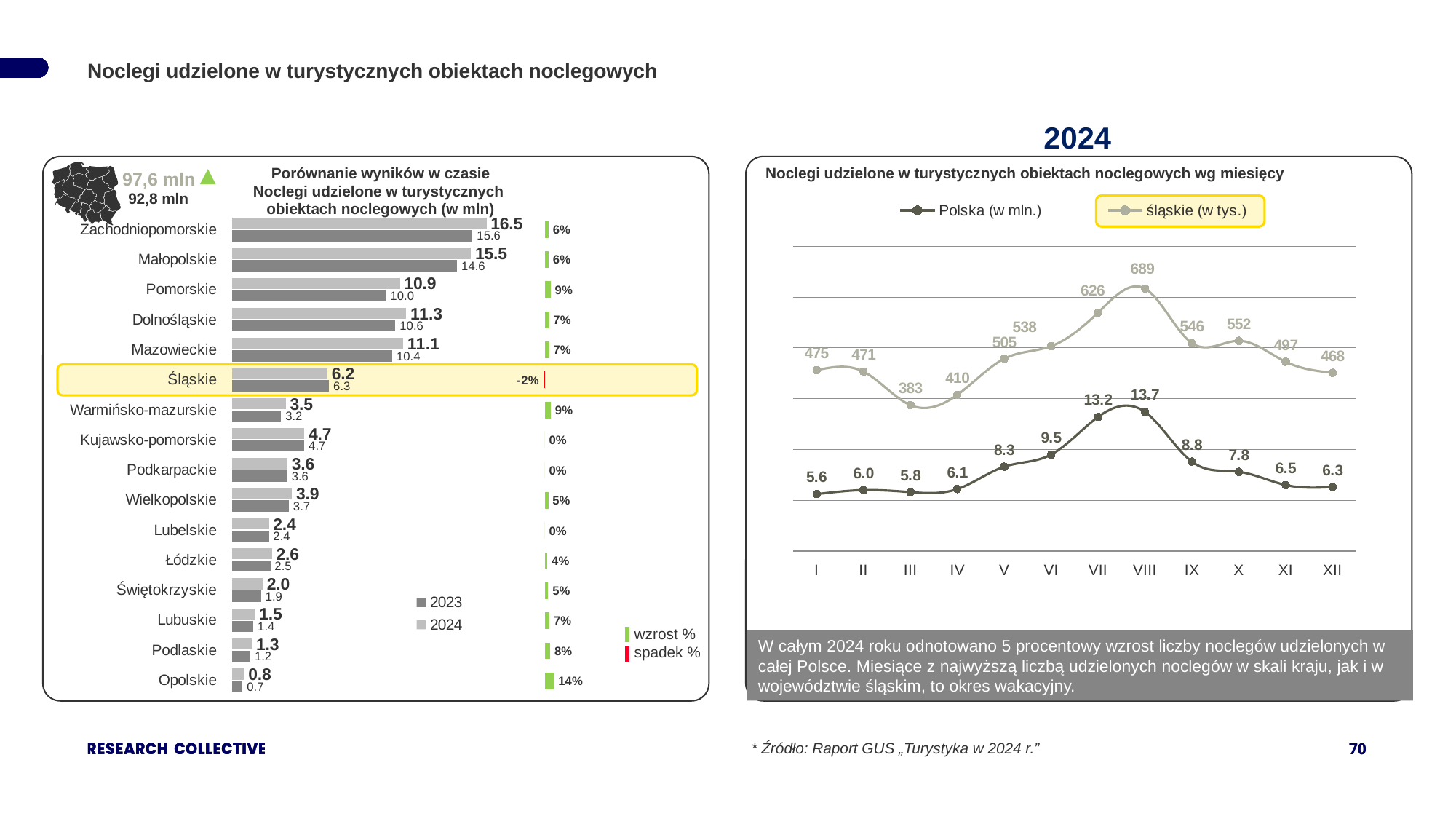
In the left bar chart 'Porównanie wyników w czasie', what is the percentage change shown for Śląskie? -2% In the right chart 'Noclegi udzielone w turystycznych obiektach noclegowych wg miesięcy', what is the value for Polska (w mln.) in month VIII? 13.7 In the right chart 'Noclegi udzielone w turystycznych obiektach noclegowych wg miesięcy', is the śląskie (w tys.) value in month IX larger or smaller than in month X? smaller In the right chart 'Noclegi udzielone w turystycznych obiektach noclegowych wg miesięcy', in which month is the śląskie (w tys.) value lowest? III In the left bar chart 'Porównanie wyników w czasie', which voivodeship has the lowest 2024 value? Opolskie In the right chart 'Noclegi udzielone w turystycznych obiektach noclegowych wg miesięcy', in which month is the śląskie (w tys.) value highest? VIII In the left bar chart 'Porównanie wyników w czasie', how many voivodeships are shown? 16 In the left bar chart 'Porównanie wyników w czasie', what is the 2024 value for Zachodniopomorskie? 16.5 In the left bar chart 'Porównanie wyników w czasie', what is the 2023 value for Małopolskie? 14.6 In the right chart 'Noclegi udzielone w turystycznych obiektach noclegowych wg miesięcy', what kind of chart is it? line chart In the left bar chart 'Porównanie wyników w czasie', how many series does the legend list? 2 In the left bar chart 'Porównanie wyników w czasie', what is the difference between the 2024 and 2023 values for Pomorskie? 0.9